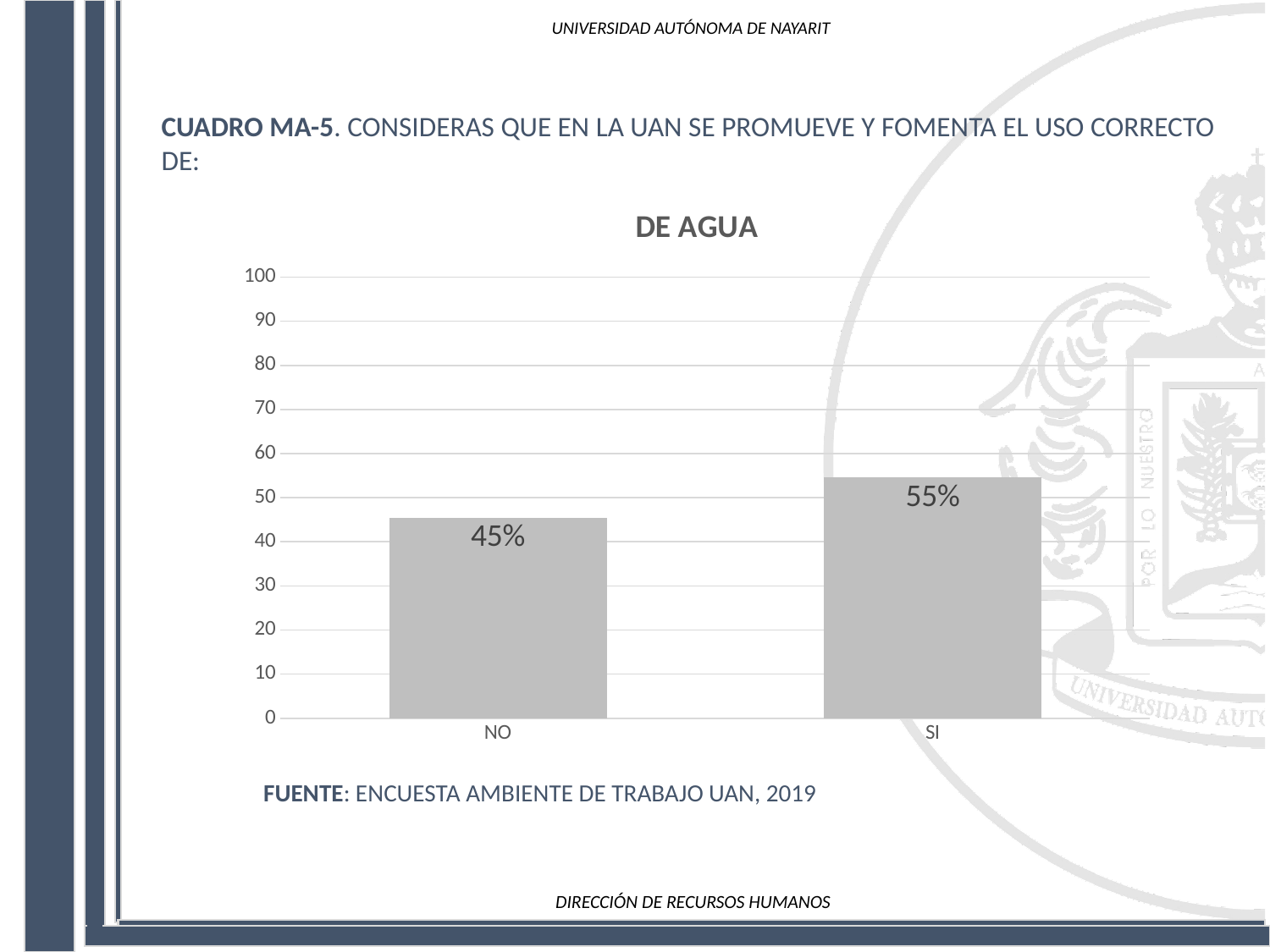
Which category has the lowest value? NO Which is larger, the value for NO or the value for SI? SI Is the value for NO greater or less than 50? less What is the value for SI? 55% How many categories are shown on the x axis? 2 What is the source cited below the chart? ENCUESTA AMBIENTE DE TRABAJO UAN, 2019 Which category has the highest value? SI What kind of chart is shown on the slide? bar chart Is the value for SI greater or less than 50? greater What is the value for NO? 45% What is the difference between the values for SI and NO? 10% What is the title of the chart? DE AGUA